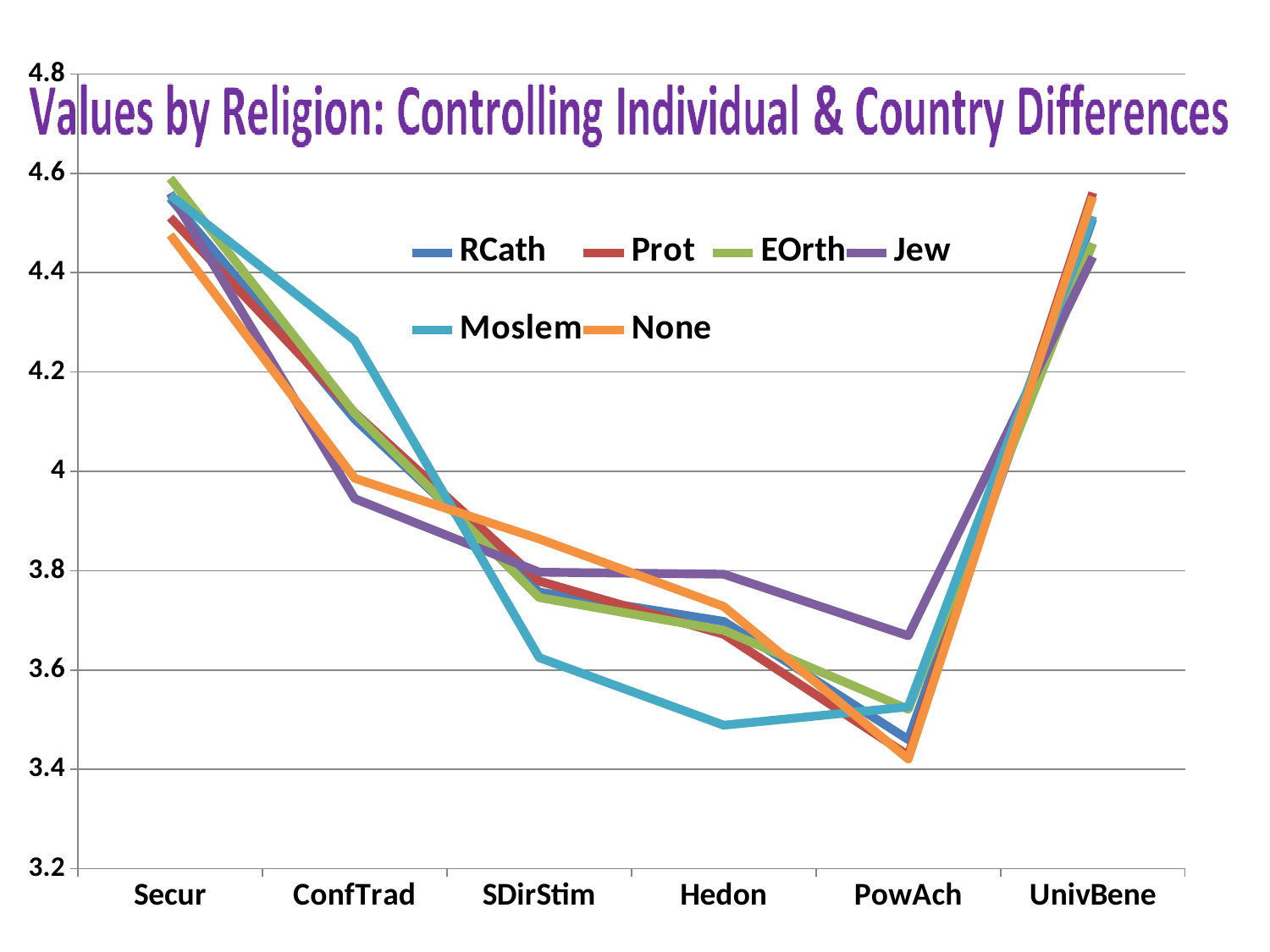
How many categories are shown along the x axis? 6 Which series has the lowest value at Hedon? Moslem Which series has the highest value at PowAch? Jew Is the value for Moslem at ConfTrad greater or less than 4.2? greater What kind of chart is shown on the slide? line chart Which series has the highest value at ConfTrad? Moslem What is the title of the chart? Values by Religion: Controlling Individual & Country Differences Is the value for Moslem at Hedon greater or less than 3.6? less Is the value for Jew at PowAch greater or less than 3.6? greater How many series does the legend list? 6 At Hedon, which is larger, the value for Jew or the value for Moslem? Jew